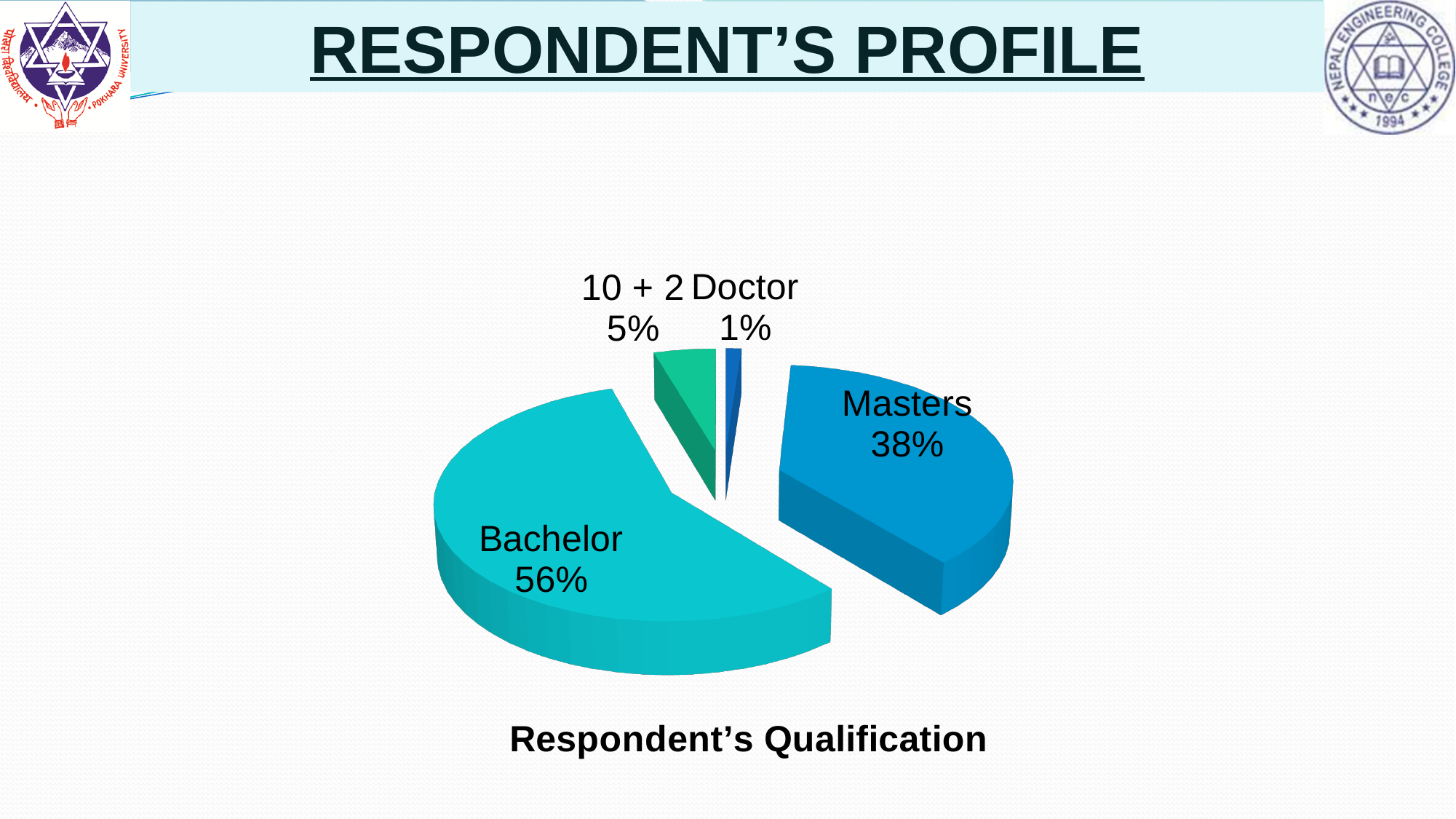
What share of respondents hold a Masters qualification? 38% Which qualification category has the smallest share of respondents? Doctor What is the combined share of the Masters and Doctor categories? 39% What share of respondents hold a Bachelor qualification? 56% Which is larger, the share for 10 + 2 or the share for Doctor? 10 + 2 What is the difference in percentage points between the Bachelor and Masters shares? 18 What share of respondents have a 10 + 2 qualification? 5% What is the title shown below the chart? Respondent's Qualification How many qualification categories are shown in the pie chart? 4 Which qualification category has the largest share of respondents? Bachelor What share of respondents hold a Doctor qualification? 1% What kind of chart is used to show the respondents' qualification? Pie chart